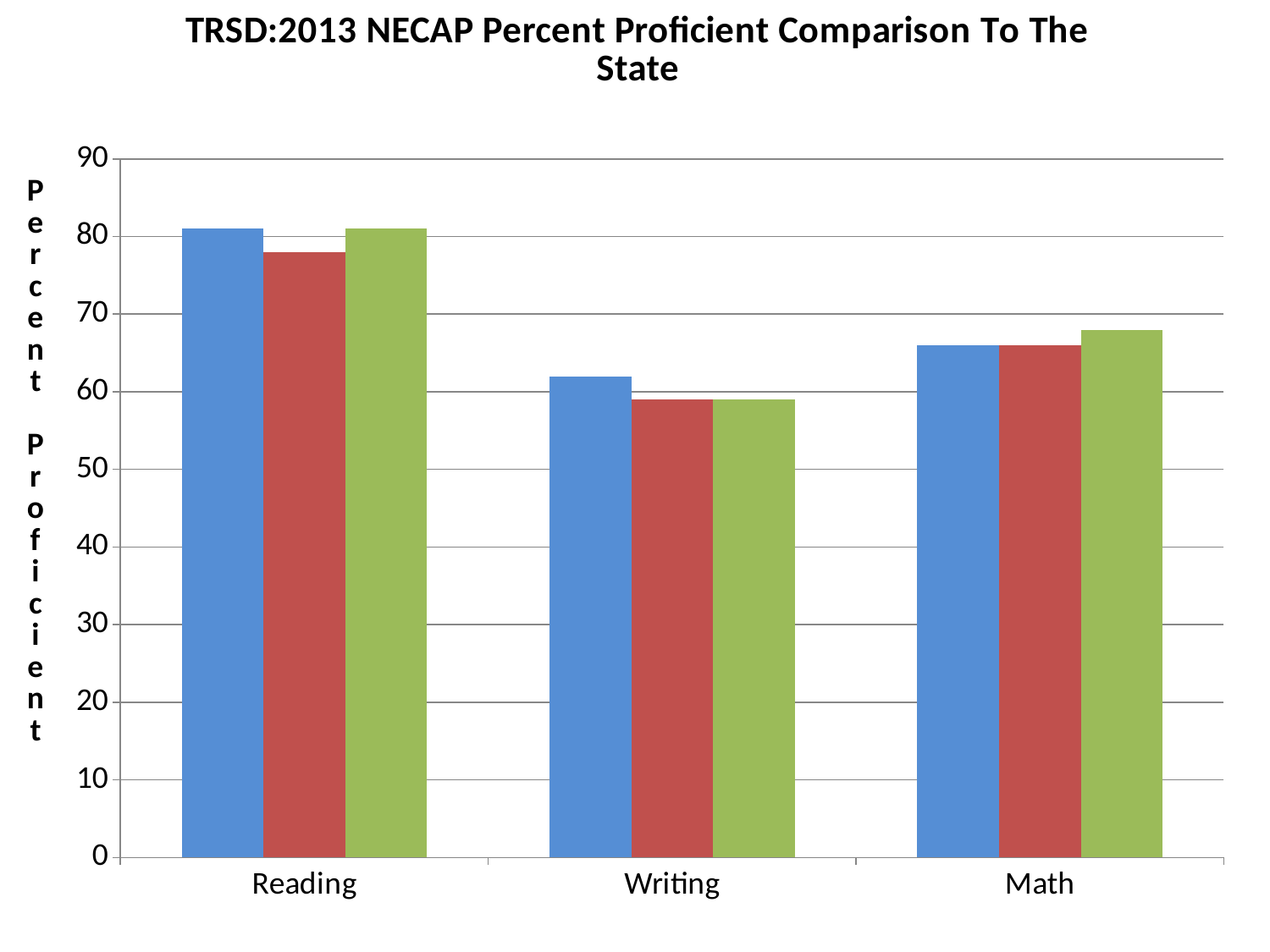
Is the red bar for Reading greater or less than 70? greater Which is larger, the green bar for Writing or the green bar for Math? Math How many categories are shown on the x axis? 3 Which category has the shortest blue bar? Writing What kind of chart is shown on the slide? bar chart Which category has the tallest blue bar? Reading Which category has the shortest green bar? Writing What is the label on the vertical axis? Percent Proficient Is the green bar for Math greater or less than 70? less Is the blue bar for Math greater or less than 60? greater Which is larger, the blue bar for Reading or the blue bar for Writing? Reading What is the title of the chart? TRSD:2013 NECAP Percent Proficient Comparison To The State